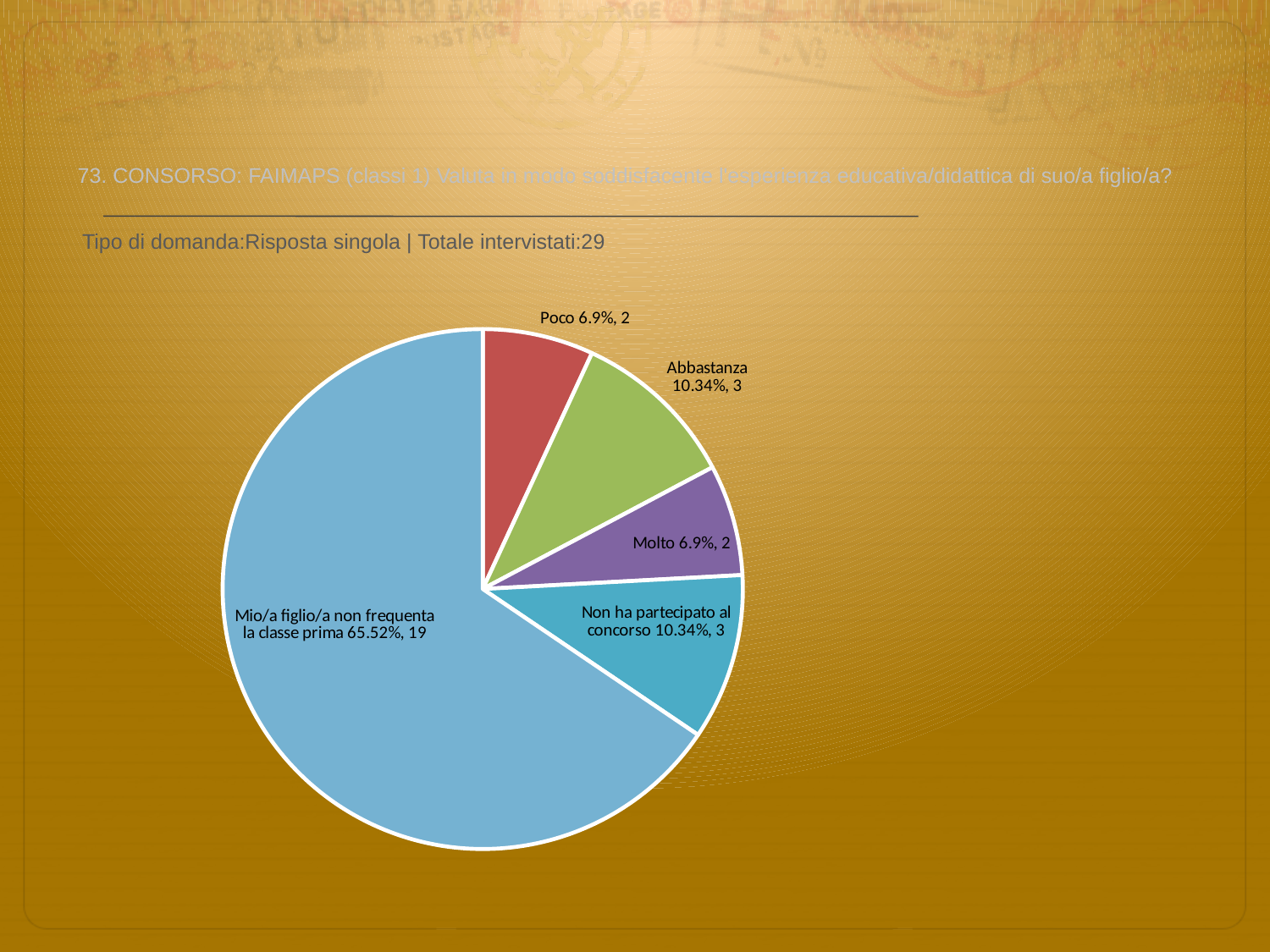
How many slices does the pie chart have? 5 What kind of chart is shown on the slide? pie chart Which category has the largest slice? Mio/a figlio/a non frequenta la classe prima What is the total number of respondents stated on the slide? 29 What is the count shown for 'Abbastanza'? 3 What percentage share does the 'Poco' slice have? 6.9% What percentage share does the 'Mio/a figlio/a non frequenta la classe prima' slice have? 65.52% What is the count shown for 'Non ha partecipato al concorso'? 3 What is the count shown for 'Molto'? 2 What colour is the 'Poco' slice? red What is the difference in count between 'Mio/a figlio/a non frequenta la classe prima' and 'Abbastanza'? 16 Which is larger, the count for 'Abbastanza' or the count for 'Molto'? Abbastanza